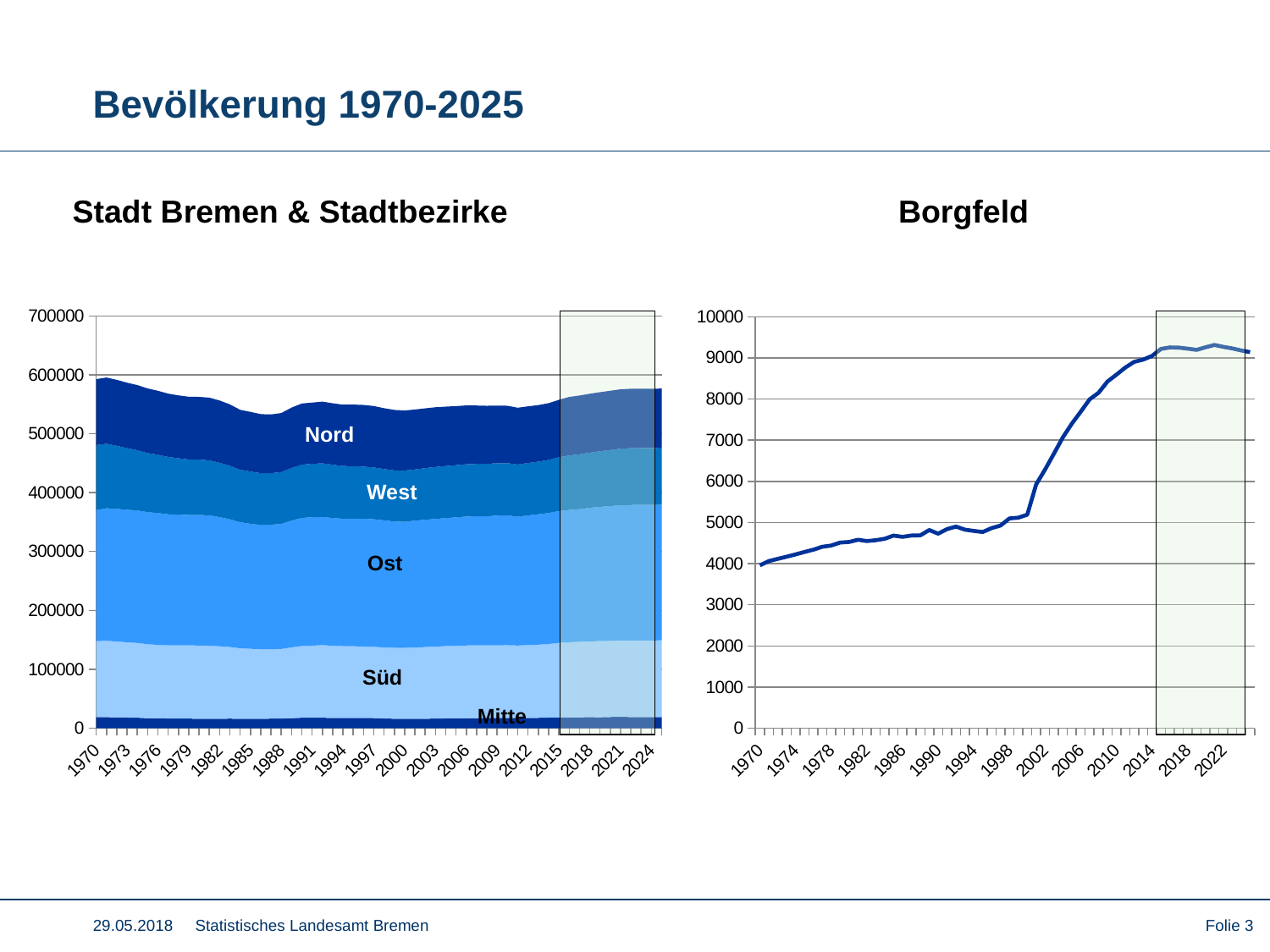
What kind of chart is the 'Stadt Bremen & Stadtbezirke' chart on the left? stacked area chart What kind of chart is the 'Borgfeld' chart on the right? line chart How many districts (series) are labelled in the 'Stadt Bremen & Stadtbezirke' chart? 5 In the 'Stadt Bremen & Stadtbezirke' chart, is the total population in 1970 greater or less than 500000? greater In the 'Stadt Bremen & Stadtbezirke' chart, does the total population rise or fall between 1970 and 1988? fall In the 'Borgfeld' chart, is the value for 2022 greater or less than 10000? less In the 'Borgfeld' chart, is the value for 1970 greater or less than 3000? greater In the 'Stadt Bremen & Stadtbezirke' chart, which district has the largest population band? Ost In the 'Borgfeld' chart, does the population rise or fall from 1970 to 2014? rise In the 'Stadt Bremen & Stadtbezirke' chart, which district has the smallest population band? Mitte